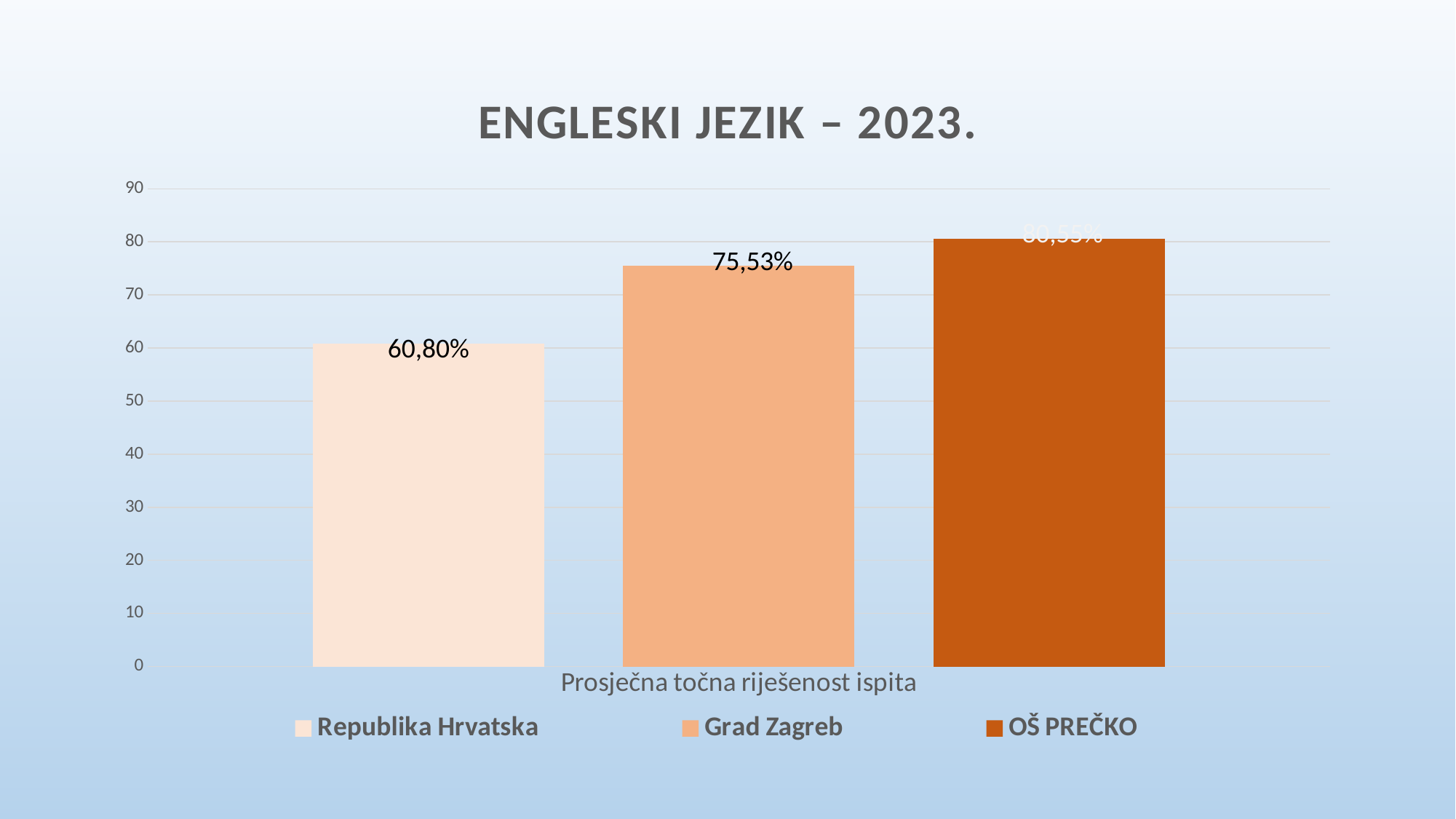
Which is larger, the value for Grad Zagreb or the value for Republika Hrvatska? Grad Zagreb What is the value for Republika Hrvatska? 60,80% How many series does the legend list? 3 What is the value for OŠ PREČKO? 80,55% Is the value for Republika Hrvatska greater or less than 70? less What is the title of the chart? ENGLESKI JEZIK – 2023. What kind of chart is shown on the slide? bar chart Which series has the highest value? OŠ PREČKO What is the value for Grad Zagreb? 75,53% What is the difference between the values for Grad Zagreb and Republika Hrvatska? 14,73% Which series has the lowest value? Republika Hrvatska What is the difference between the values for OŠ PREČKO and Grad Zagreb? 5,02%